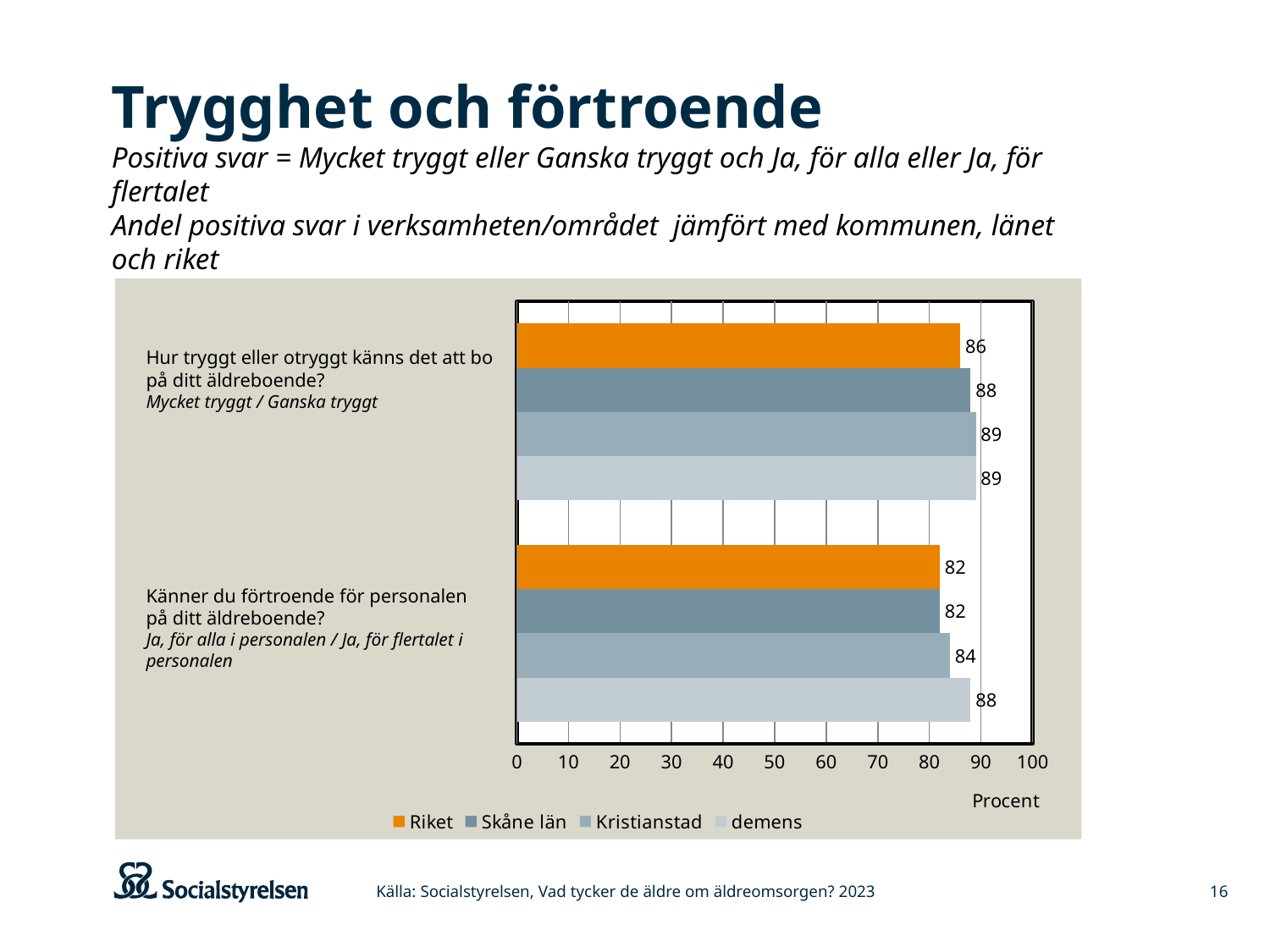
What is the value for Riket on the question 'Hur tryggt eller otryggt känns det att bo på ditt äldreboende?' 86 How many question categories are shown on the chart? 2 What is the value for Skåne län on the question 'Hur tryggt eller otryggt känns det att bo på ditt äldreboende?' 88 What unit label is shown on the x axis of the chart? Procent What type of chart is shown on the slide? bar chart What is the difference between the demens value and the Riket value on the question 'Känner du förtroende för personalen på ditt äldreboende?' 6 Which series has the lowest value on the question 'Hur tryggt eller otryggt känns det att bo på ditt äldreboende?' Riket How many series does the legend list? 4 What is the value for Kristianstad on the question 'Känner du förtroende för personalen på ditt äldreboende?' 84 Which series has the highest value on the question 'Känner du förtroende för personalen på ditt äldreboende?' demens Which is larger on the question 'Känner du förtroende för personalen på ditt äldreboende?': the value for Kristianstad or the value for demens? demens What is the value for demens on the question 'Känner du förtroende för personalen på ditt äldreboende?' 88